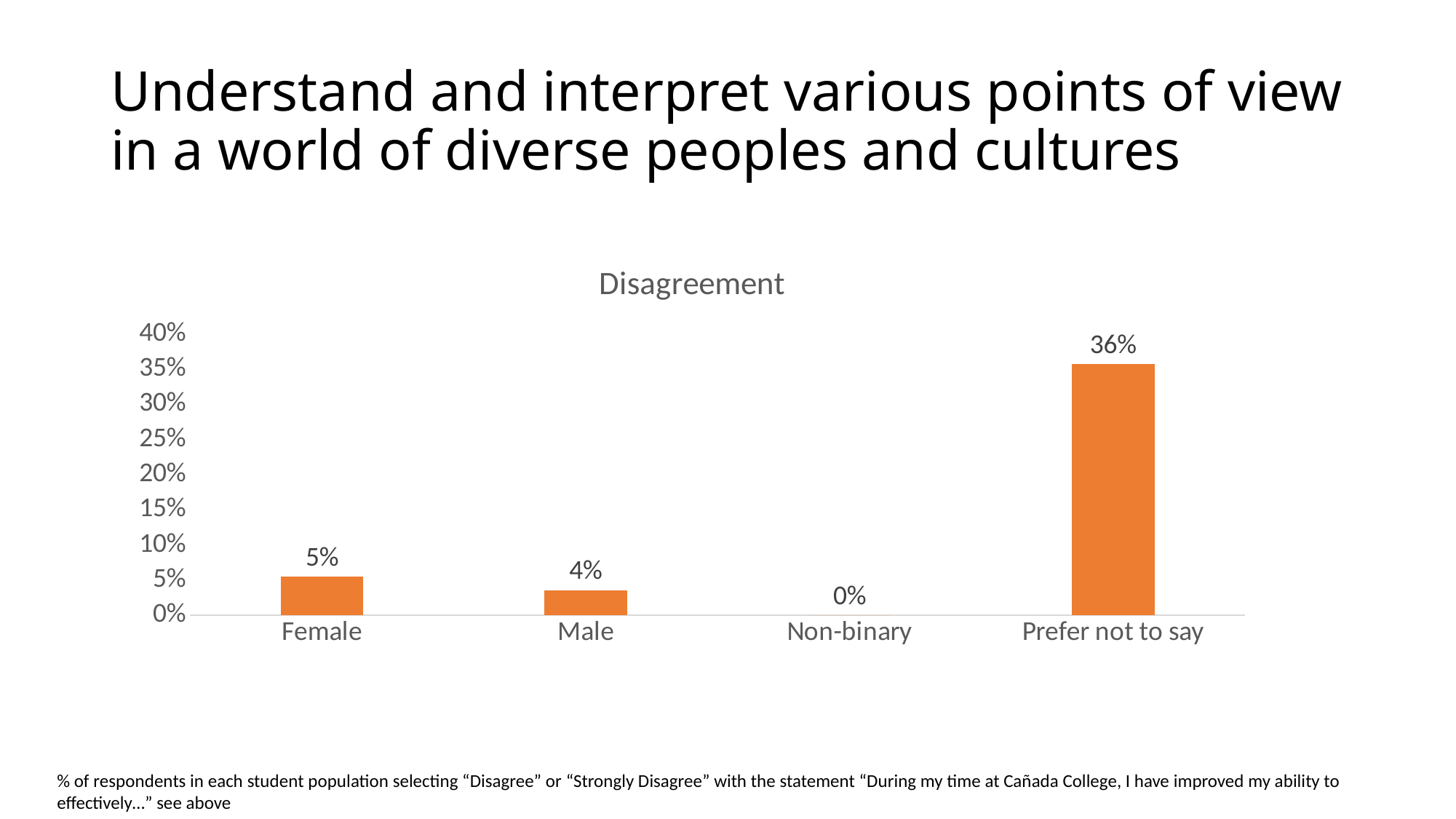
Which category has the highest value? Prefer not to say Which is larger, the value for Female or the value for Male? Female What is the value for Male? 4% What is the difference between the values for Female and Male? 1% What is the value for Non-binary? 0% What is the value for Prefer not to say? 36% What kind of chart is shown? Bar chart What is the difference between the values for Prefer not to say and Female? 31% Is the value for Prefer not to say greater or less than 30%? greater Which category has the lowest value? Non-binary How many categories are shown on the x axis? 4 What is the value for Female? 5%